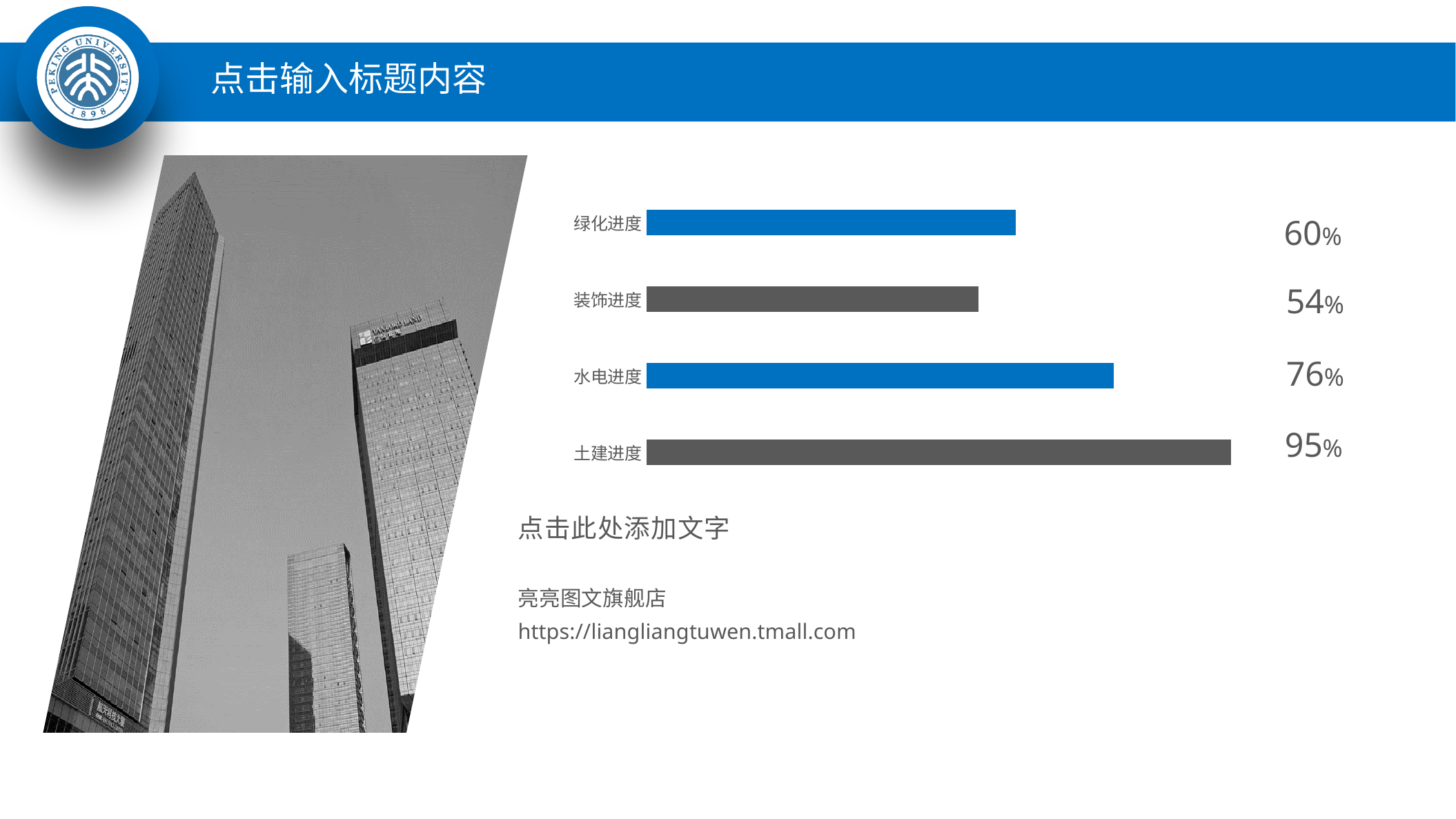
Which category has the lowest value? 装饰进度 What is the value shown for 绿化进度? 60% What colour is the bar for 土建进度? dark grey What is the difference between the values for 土建进度 and 水电进度? 19% What is the value shown for 土建进度? 95% What is the difference between the values for 绿化进度 and 装饰进度? 6% What is the value shown for 装饰进度? 54% Which is larger, the value for 水电进度 or the value for 绿化进度? 水电进度 What kind of chart is shown on the slide? bar chart How many categories are shown in the chart? 4 Which category has the highest value? 土建进度 What is the value shown for 水电进度? 76%